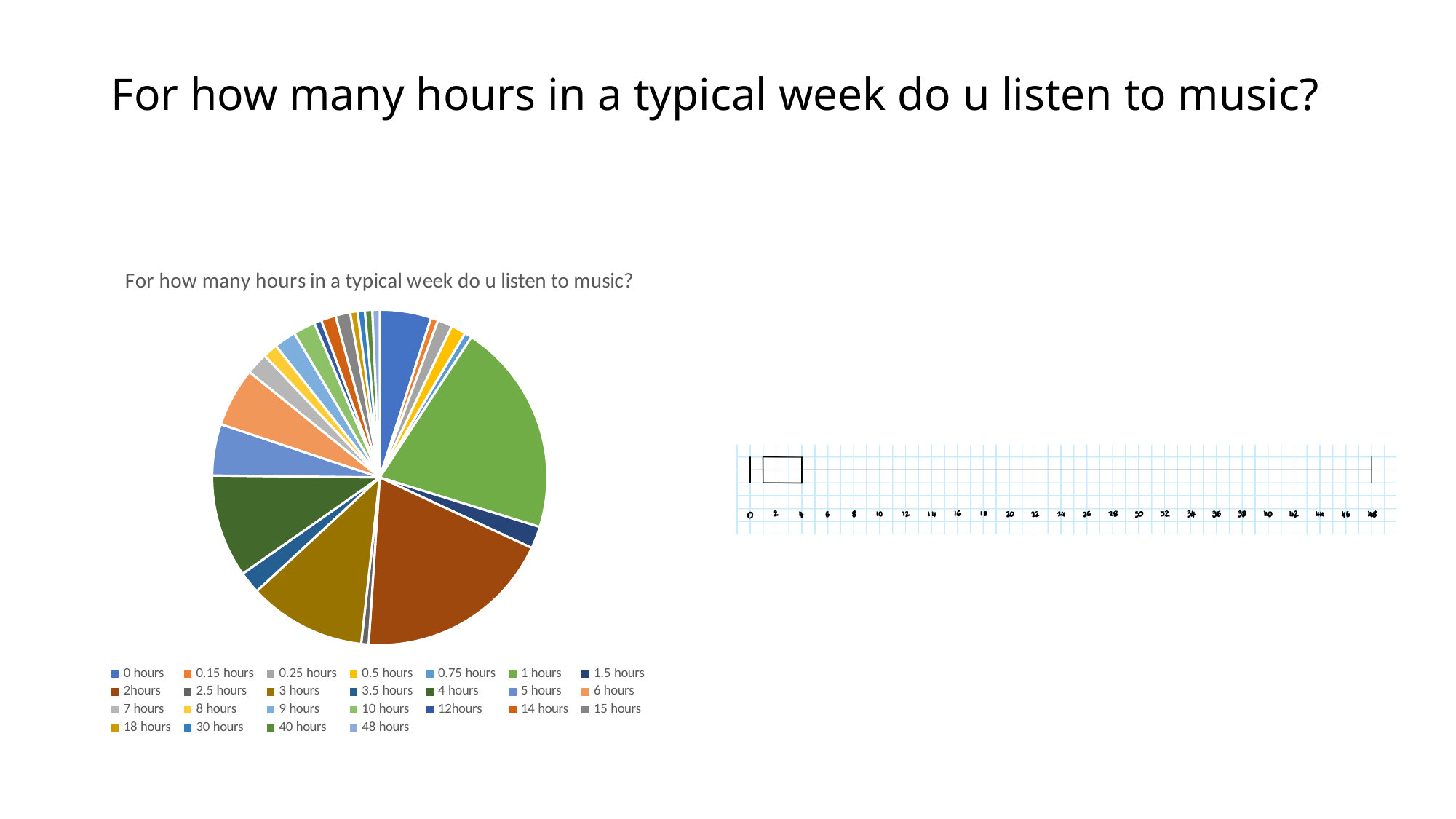
In the pie chart, which slice is larger: 2hours or 4 hours? 2hours How many categories does the legend of the pie chart list? 25 What kind of chart is the chart on the left of the slide? pie chart In the pie chart, which slice is larger: 3 hours or 3.5 hours? 3 hours In the pie chart, which slice is larger: 1 hours or 3 hours? 1 hours In the box plot on the right, what is the highest value the axis is labelled with? 48 In the pie chart, what colour is the slice for 2hours? brown What kind of chart is the hand-drawn chart on the right of the slide? box plot In the box plot on the right, at what value does the right whisker end? 48 What is the title of the pie chart? For how many hours in a typical week do u listen to music? In the box plot on the right, at what value does the left whisker end? 0